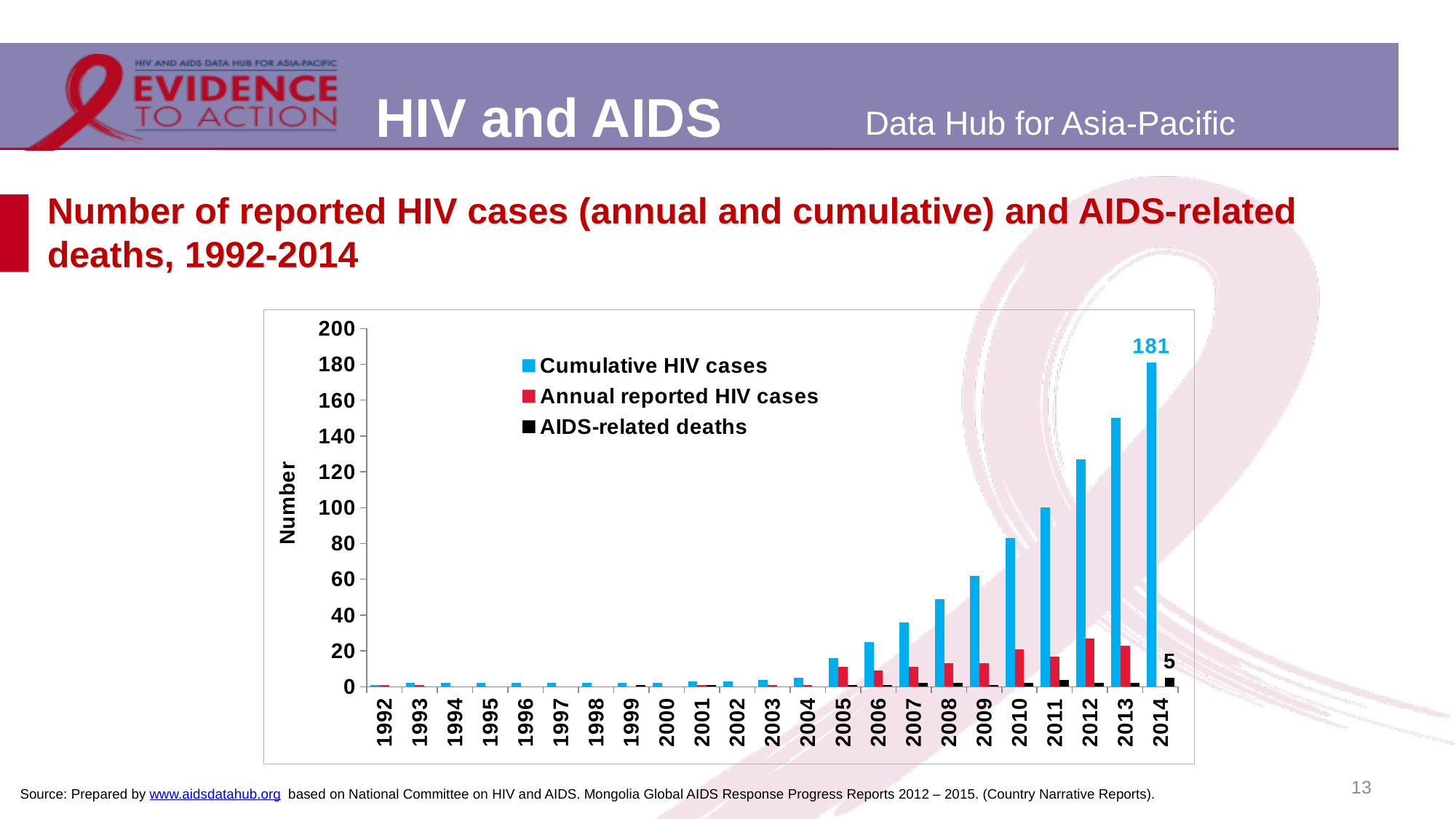
How many series does the legend list? 3 Is the value for Cumulative HIV cases in 2013 greater or less than 140? greater What is the value of AIDS-related deaths in 2014? 5 What is the label of the y axis? Number What is the value of Cumulative HIV cases in 2014? 181 Do the Cumulative HIV cases values rise or fall from 1992 to 2014? Rise Is the value for Cumulative HIV cases in 2010 greater or less than 60? greater Is the value for Cumulative HIV cases in 2005 greater or less than 20? less Which is larger in 2014: Cumulative HIV cases or AIDS-related deaths? Cumulative HIV cases What type of chart is shown on the slide? Bar chart Which year has the highest value for Cumulative HIV cases? 2014 How many years are shown on the x axis? 23